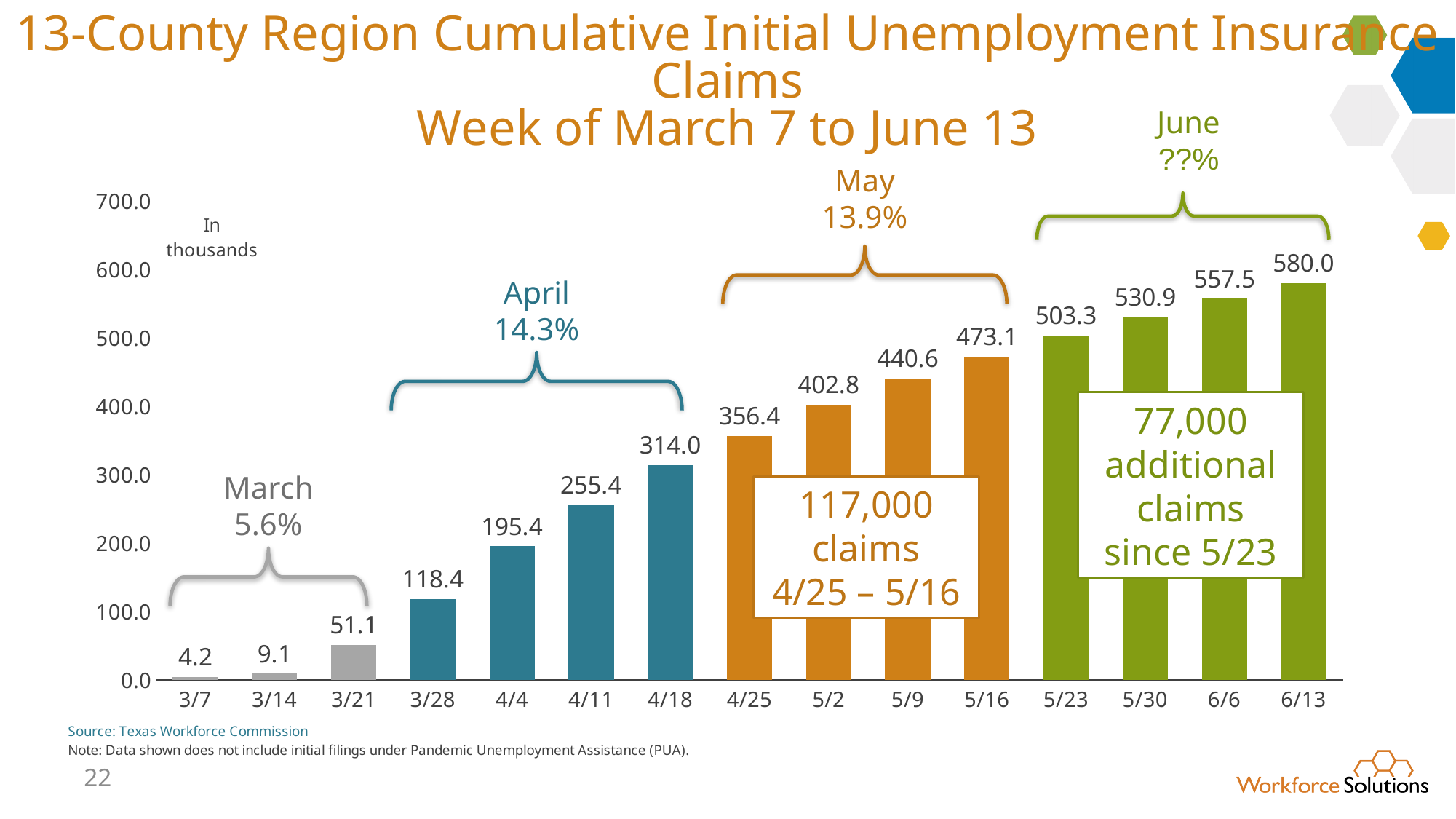
Which week has the highest value? 6/13 What is the value for 5/2? 402.8 Which is larger, the value for 4/11 or the value for 4/25? 4/25 What is the difference between the values for 6/13 and 5/23? 76.7 What percentage is shown for April? 14.3% What is the value for 4/18? 314.0 What kind of chart is shown? bar chart What is the value for 3/21? 51.1 Do the values rise or fall from 3/7 to 6/13? rise How many weeks are shown on the x axis? 15 Is the value for 5/9 greater or less than 400.0? greater Which week has the lowest value? 3/7